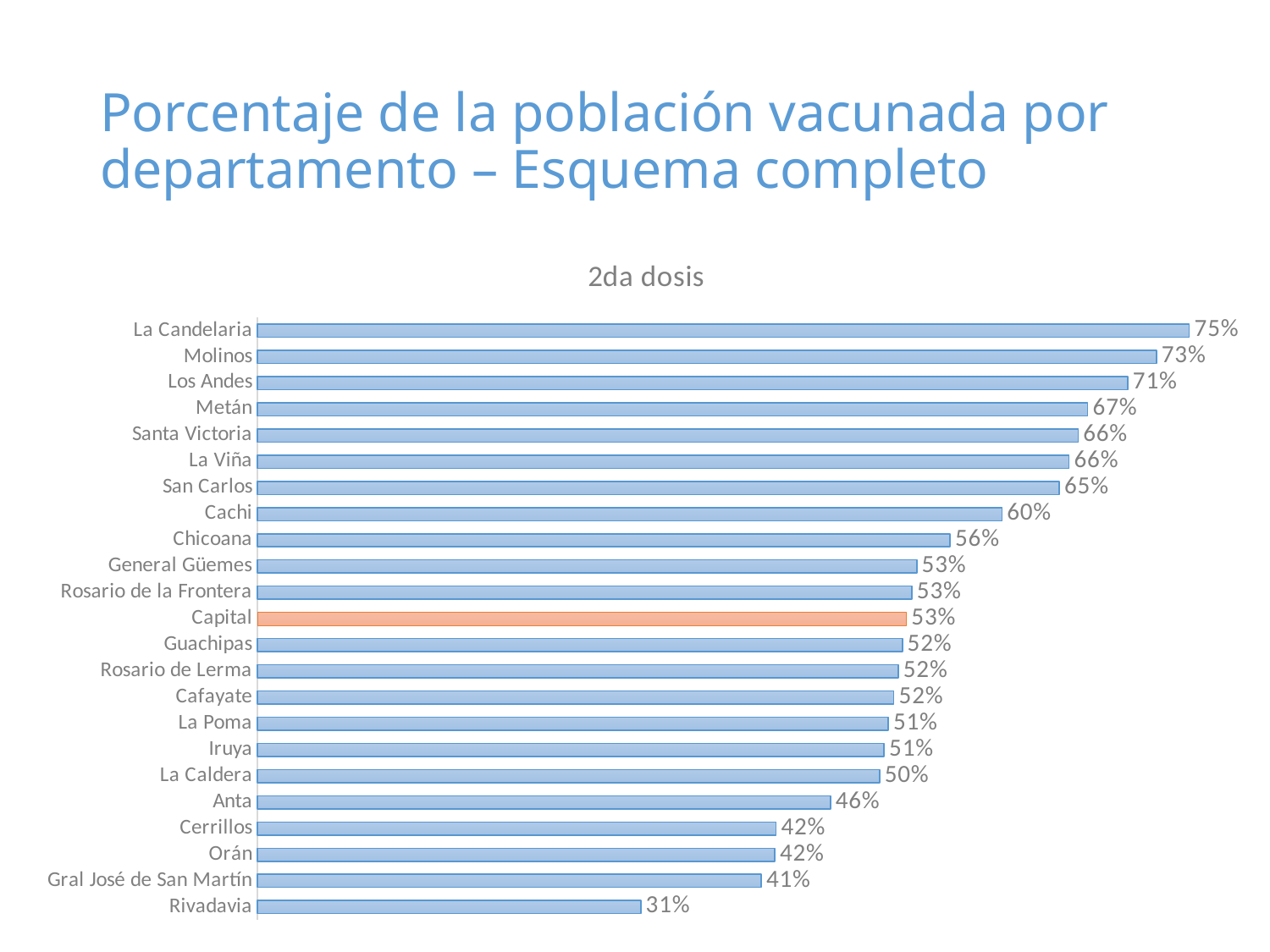
What is the difference between the values for La Candelaria and Rivadavia? 44% What is the difference between the values for Metán and Anta? 21% How many departments are shown in the chart? 23 Which department's bar is highlighted in a different colour (orange) from the others? Capital What is the value for Gral José de San Martín? 41% What kind of chart is shown on the slide? Bar chart Which has a larger value, Chicoana or La Caldera? Chicoana What is the value for Cachi? 60% Which department has the lowest value? Rivadavia Which department has the highest value? La Candelaria Which has a larger value, Molinos or San Carlos? Molinos What is the value for Capital? 53%